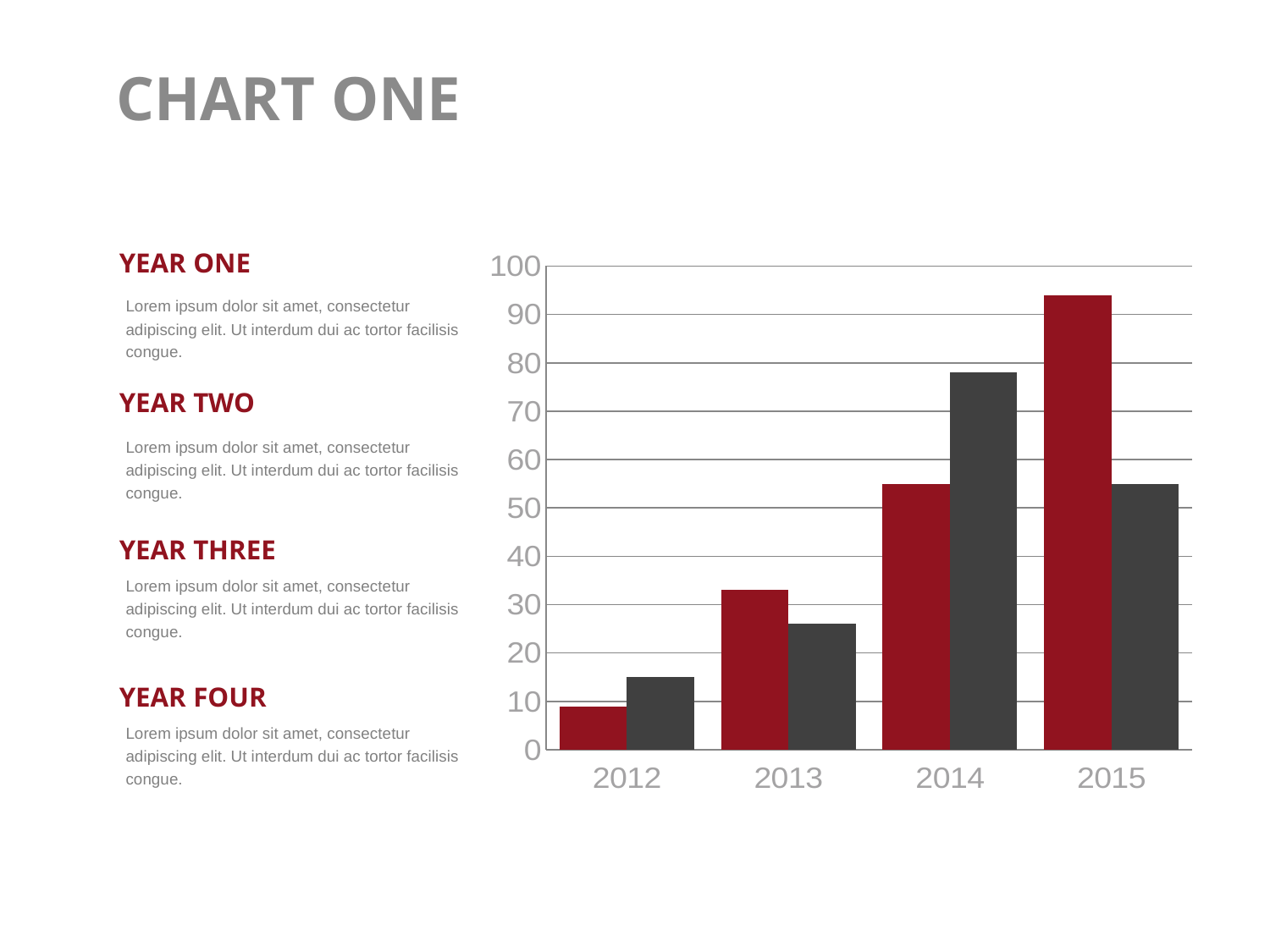
How many years are shown on the x axis of the chart? 4 What kind of chart is shown on the slide? bar chart Is the value of the red bar for 2012 greater or less than 20? less Is the value of the red bar for 2015 greater or less than 90? greater For 2014, which bar is taller, the red bar or the dark gray bar? dark gray For 2015, which bar is taller, the red bar or the dark gray bar? red In which year is the red bar the tallest? 2015 In which year is the red bar the shortest? 2012 Is the value of the dark gray bar for 2013 greater or less than 30? less Do the red bars rise or fall from 2012 to 2015? rise In which year is the dark gray bar the tallest? 2014 How many bars are plotted for each year in the chart? 2